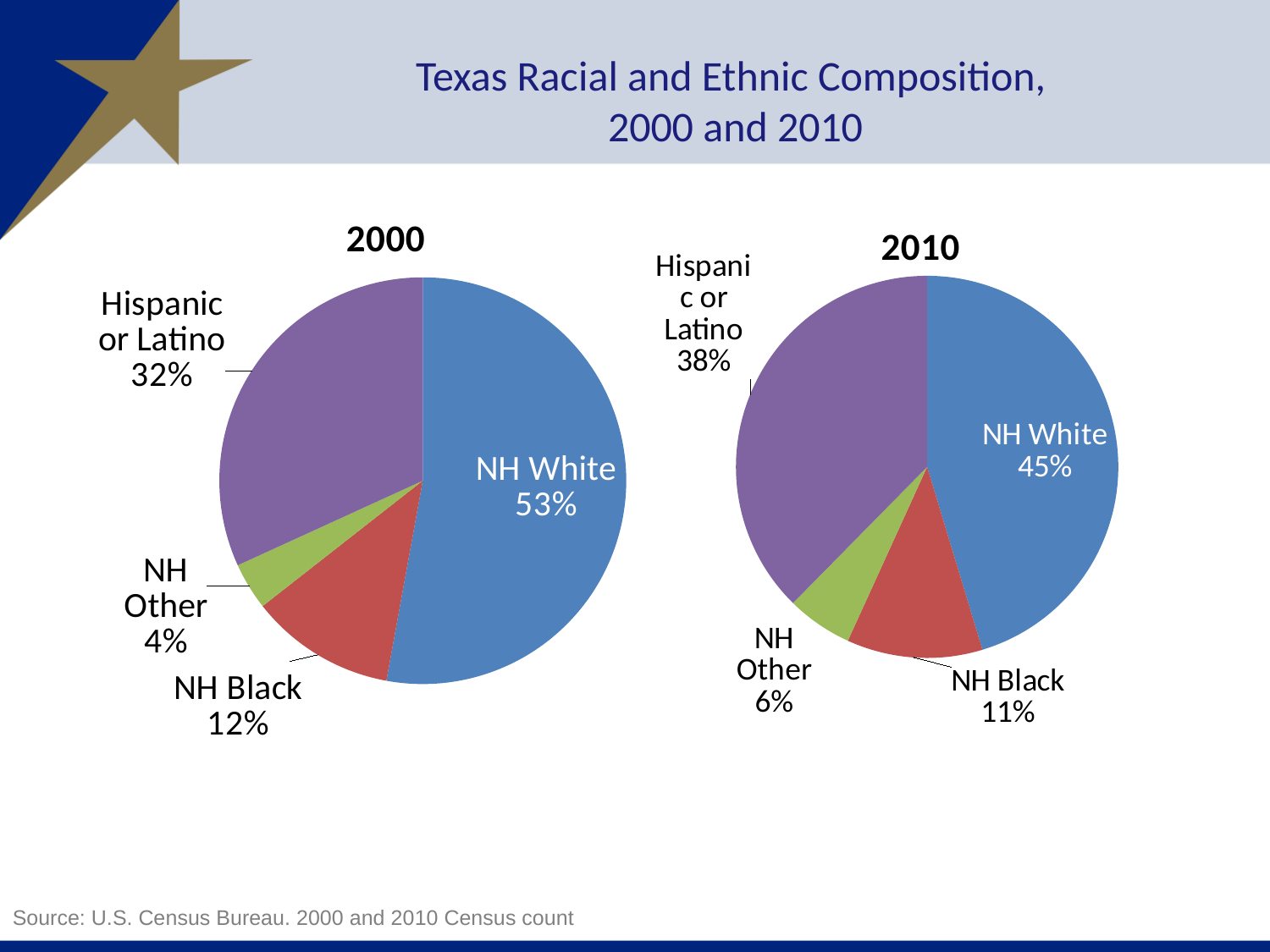
How many slices does the 2010 pie chart have? 4 What kind of chart is used to show the 2000 composition? Pie chart In the 2010 pie chart, what share is Hispanic or Latino? 38% In the 2010 pie chart, which group has the largest share? NH White Which is larger: the Hispanic or Latino share in 2000 or in 2010? 2010 In the 2000 pie chart, what share is NH White? 53% What is the difference between the NH White share in 2000 and in 2010? 8 percentage points What is the difference between the NH Black share in 2000 and in 2010? 1 percentage point What is the title of the slide containing the two pie charts? Texas Racial and Ethnic Composition, 2000 and 2010 In the 2010 pie chart, what share is NH Other? 6% In the 2000 pie chart, what share is NH Black? 12% In the 2000 pie chart, which group has the smallest share? NH Other